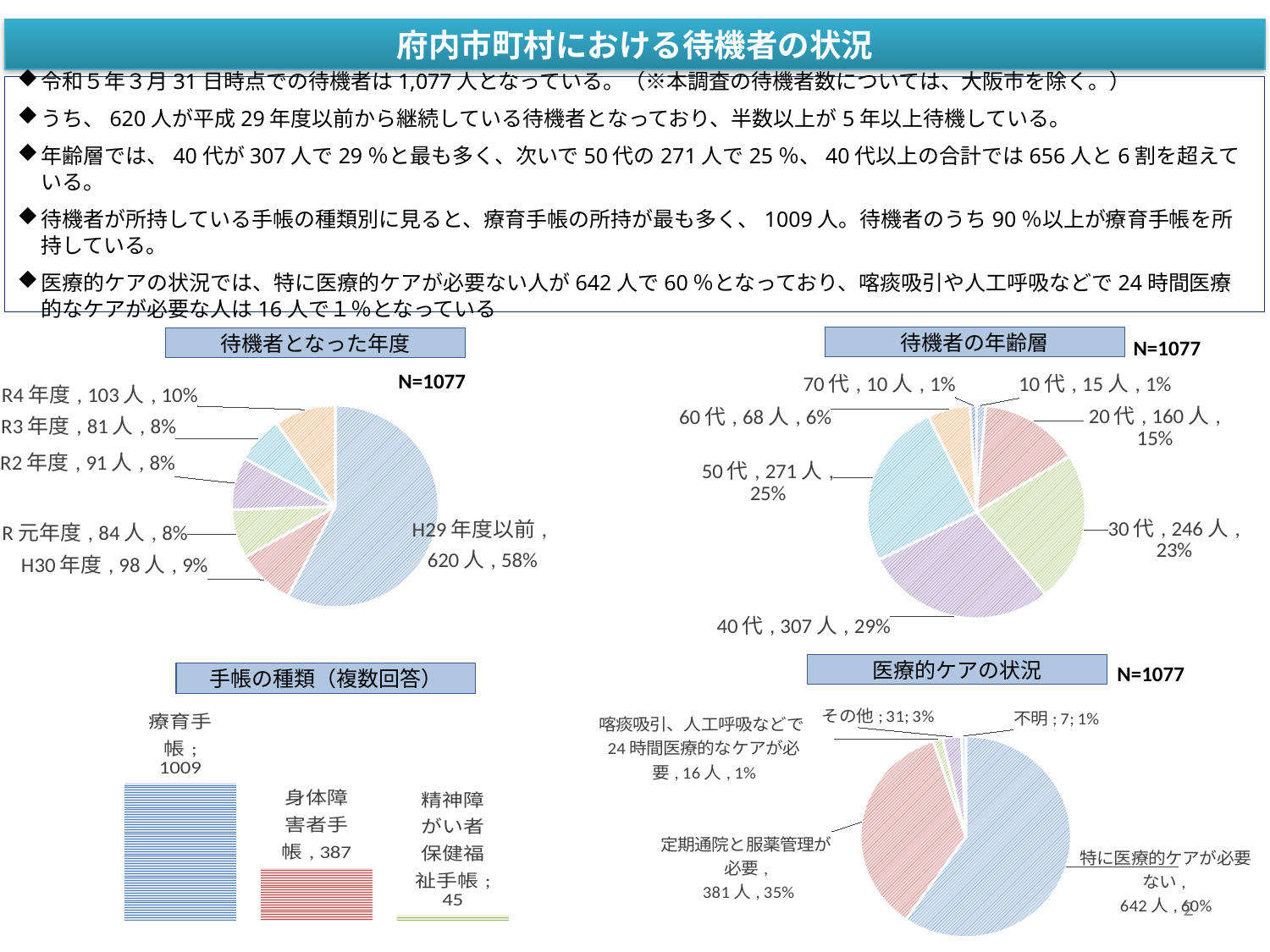
What kind of chart is the 手帳の種類（複数回答） chart? bar chart In the 待機者となった年度 pie chart, how many people are in the H29年度以前 category? 620人 In the 手帳の種類（複数回答） chart, what is the value for 身体障害者手帳? 387 In the 待機者の年齢層 pie chart, which is larger, 20代 or 30代? 30代 In the 待機者となった年度 pie chart, what is the difference in people between H30年度 and R元年度? 14人 In the 医療的ケアの状況 pie chart, how many people are in the 定期通院と服薬管理が必要 category? 381人 In the 待機者となった年度 pie chart, what share of the pie does R4年度 represent? 10% In the 待機者の年齢層 pie chart, how many people are in the 50代 category? 271人 In the 待機者の年齢層 pie chart, which age group has the largest number of people? 40代 In the 手帳の種類（複数回答） chart, which category has the lowest value? 精神障がい者保健福祉手帳 In the 待機者となった年度 pie chart, how many categories are shown? 6 In the 待機者の年齢層 pie chart, what is the difference in people between 40代 and 50代? 36人